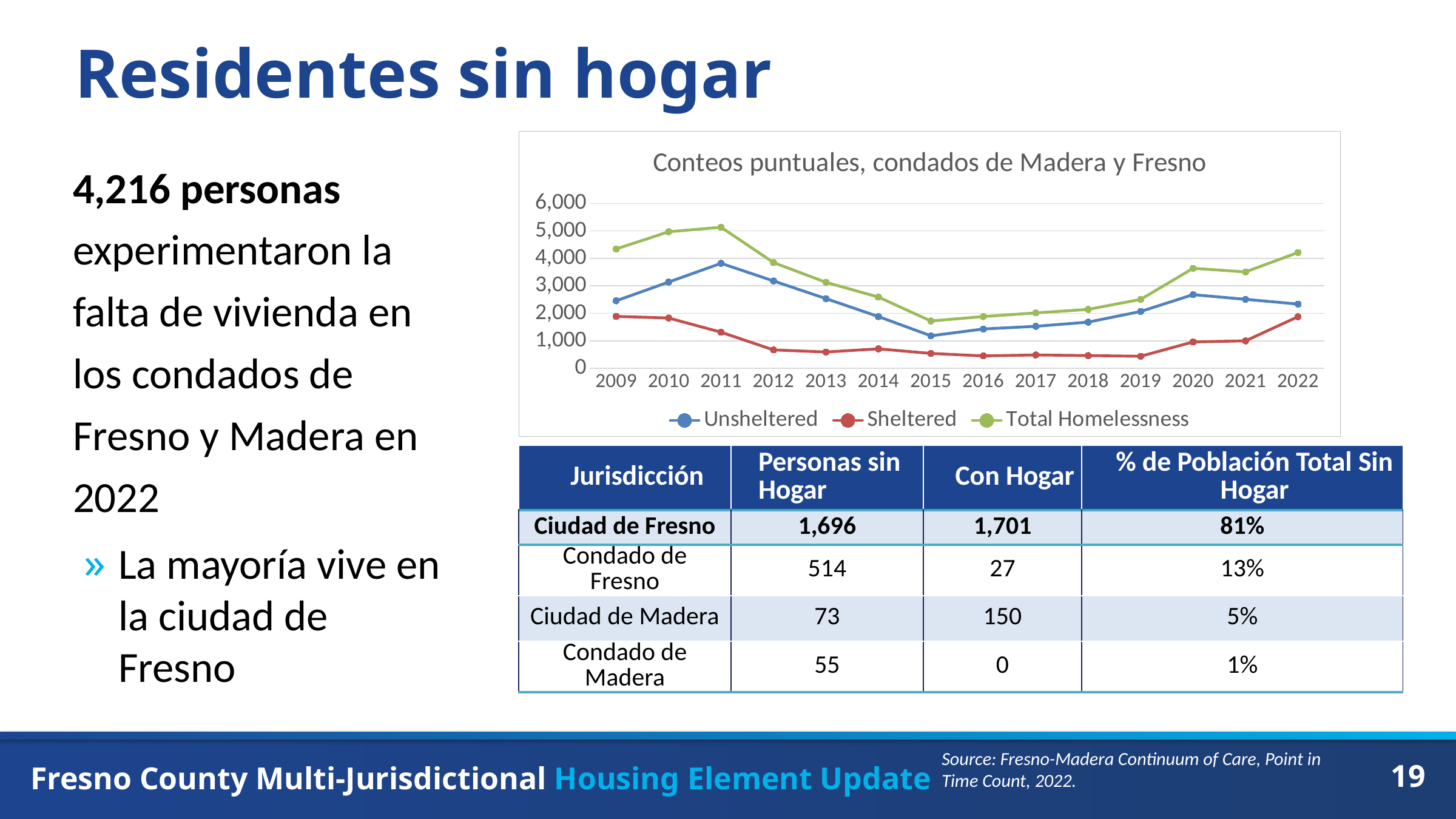
In 2022, which is larger: the Unsheltered value or the Sheltered value? Unsheltered In which year does the Unsheltered series reach its highest value? 2011 What is the title of the chart? Conteos puntuales, condados de Madera y Fresno In which year does the Unsheltered series reach its lowest value? 2015 In which year does the Total Homelessness series reach its highest value? 2011 What kind of chart is shown on the slide? line chart How many years are shown along the x axis of the chart? 14 Does the Total Homelessness series rise or fall between 2011 and 2015? fall Is the Unsheltered value for 2020 greater or less than 2,000? greater Is the Sheltered value for 2016 greater or less than 1,000? less Is the Total Homelessness value for 2022 greater or less than 4,000? greater How many series does the chart legend list? 3